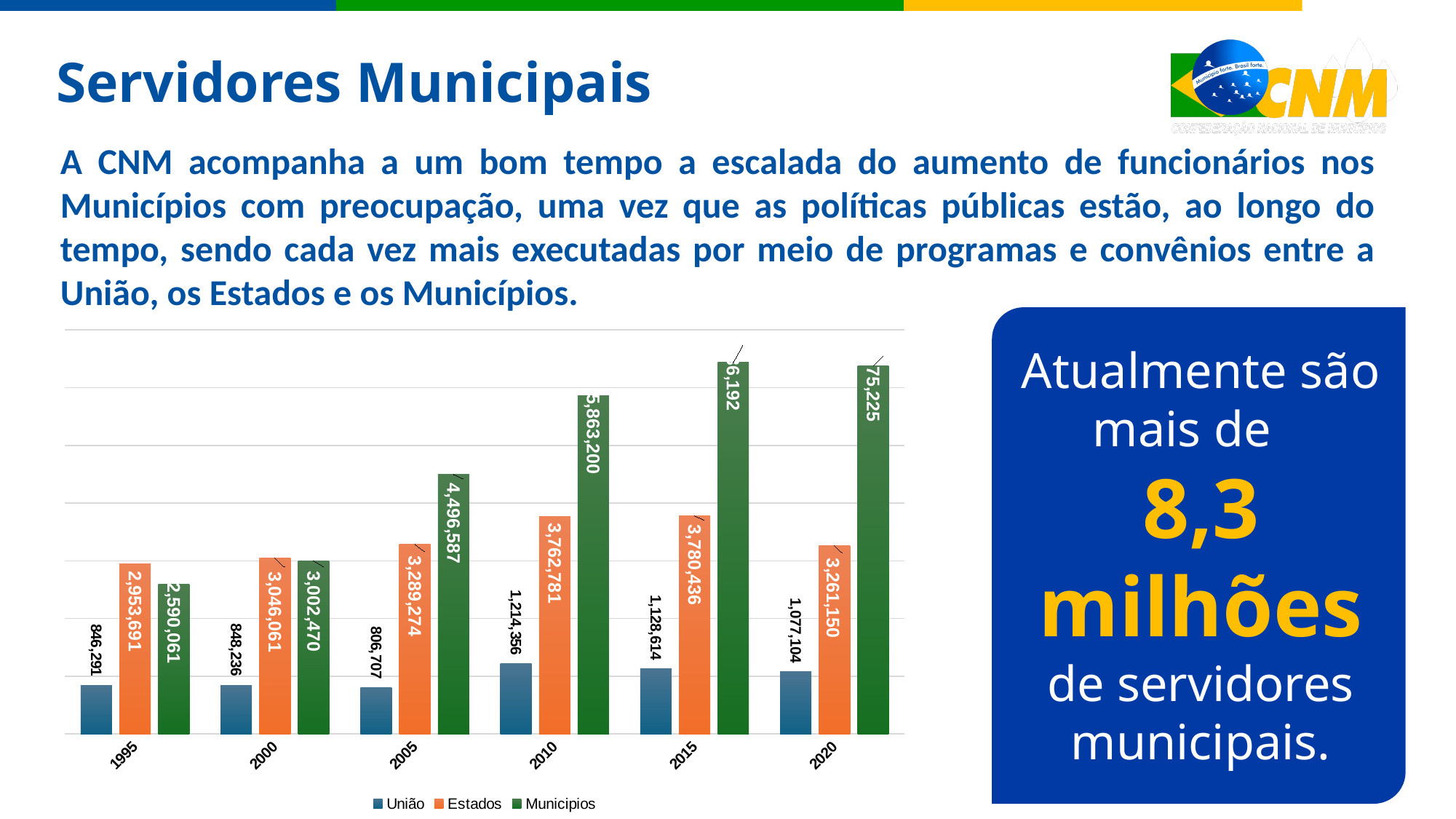
In which year is the União value highest? 2010 In which year is the União value lowest? 2005 How many years are shown on the x axis? 6 What kind of chart is shown on the slide? Bar chart In 1995, which is larger: Estados or Municipios? Estados What is the difference between the Municipios value in 2005 and in 2000? 1,494,117 What is the value for Estados in 2010? 3,762,781 What is the value for Municipios in 2005? 4,496,587 What is the difference between the Estados value in 2015 and in 2020? 519,286 How many series does the legend list? 3 Do the Municipios values rise or fall from 1995 to 2015? Rise What is the value for União in 1995? 846,291